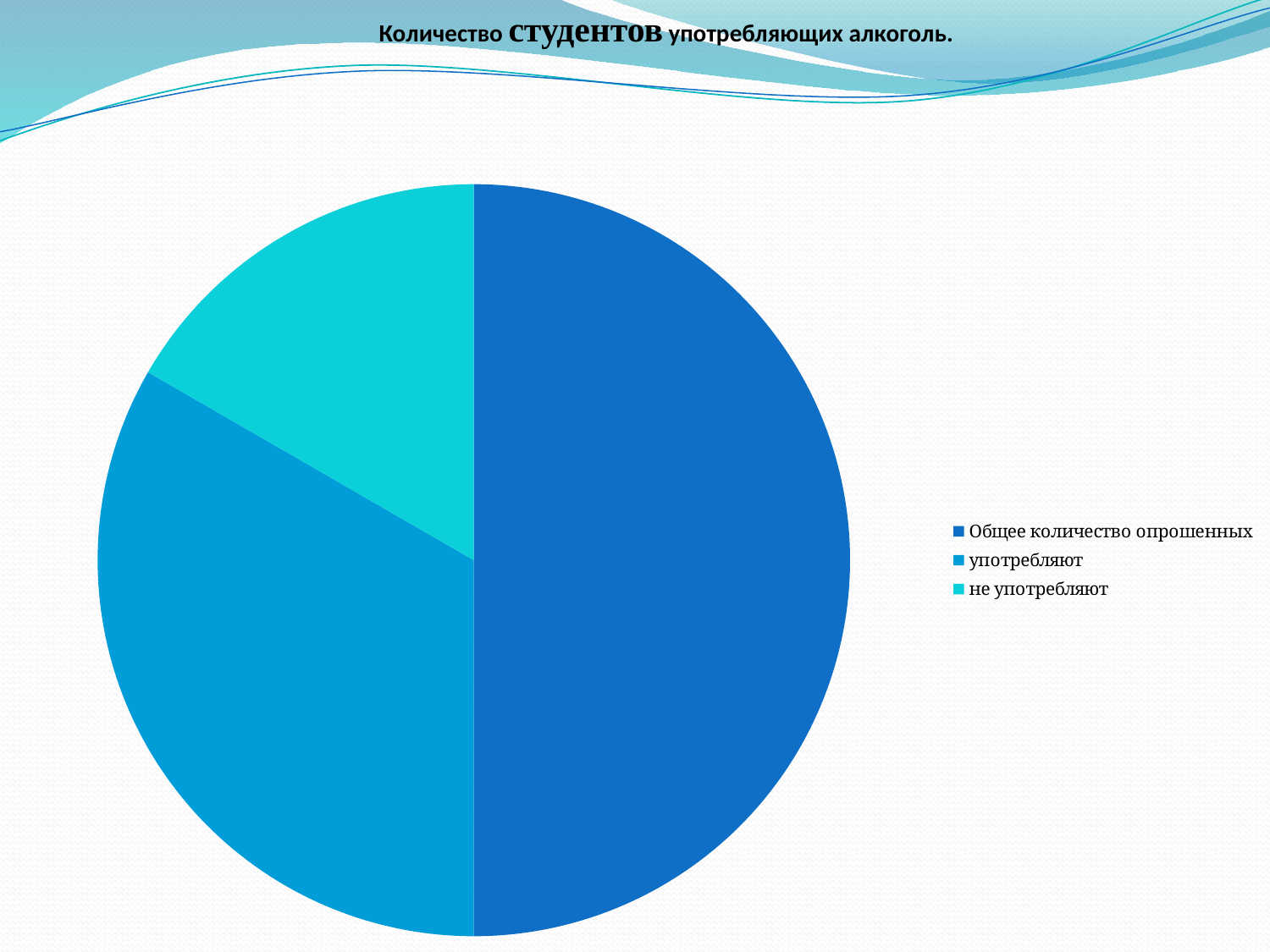
Which slice is larger: "Общее количество опрошенных" or "не употребляют"? Общее количество опрошенных How many entries does the legend list? 3 What is the title of the chart on the slide? Количество студентов употребляющих алкоголь. How many slices does the pie chart have? 3 Which category has the smallest slice of the pie? не употребляют What kind of chart is shown on the slide? pie chart Which legend entry is shown in the lightest (cyan) colour? не употребляют Which category has the largest slice of the pie? Общее количество опрошенных Which slice is larger: "употребляют" or "не употребляют"? употребляют